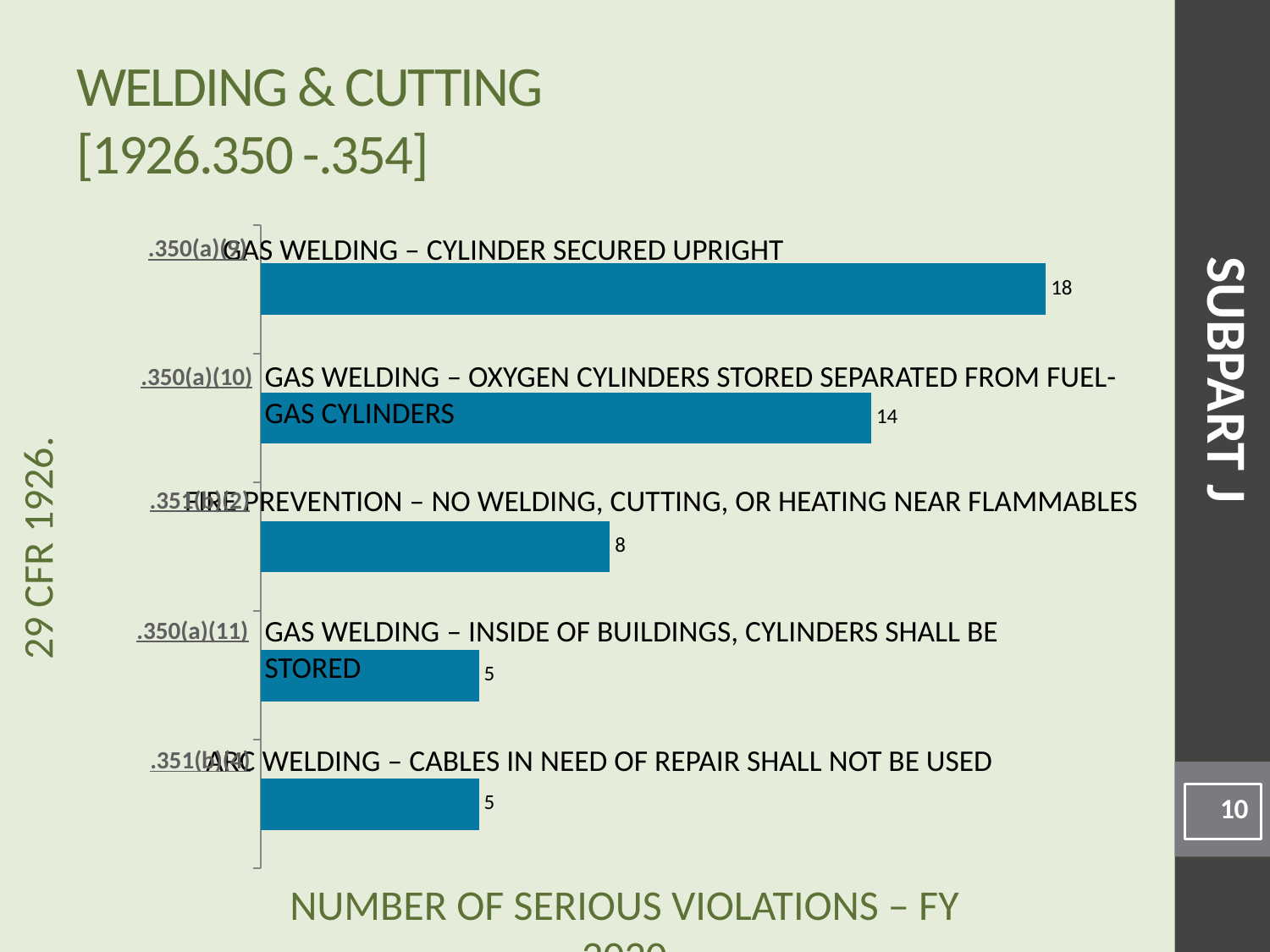
What is the value for 'Arc welding – cables in need of repair shall not be used'? 5 What type of chart is shown on the slide? Bar chart What is the difference between the values for 'Fire prevention – no welding, cutting, or heating near flammables' and 'Gas welding – inside of buildings, cylinders shall be stored'? 3 How many categories have a value of 5? 2 How many categories are plotted in the chart? 5 Which has more serious violations: 'Fire prevention – no welding, cutting, or heating near flammables' or 'Gas welding – inside of buildings, cylinders shall be stored'? Fire prevention – no welding, cutting, or heating near flammables Which category has the highest number of serious violations? Gas welding – cylinder secured upright How many serious violations are shown for 'Gas welding – cylinder secured upright'? 18 What is the total of all the values shown in the chart? 50 How many serious violations are shown for 'Fire prevention – no welding, cutting, or heating near flammables'? 8 What is the value for 'Gas welding – oxygen cylinders stored separated from fuel-gas cylinders'? 14 What is the difference between the violations for 'Gas welding – cylinder secured upright' and 'Gas welding – oxygen cylinders stored separated from fuel-gas cylinders'? 4